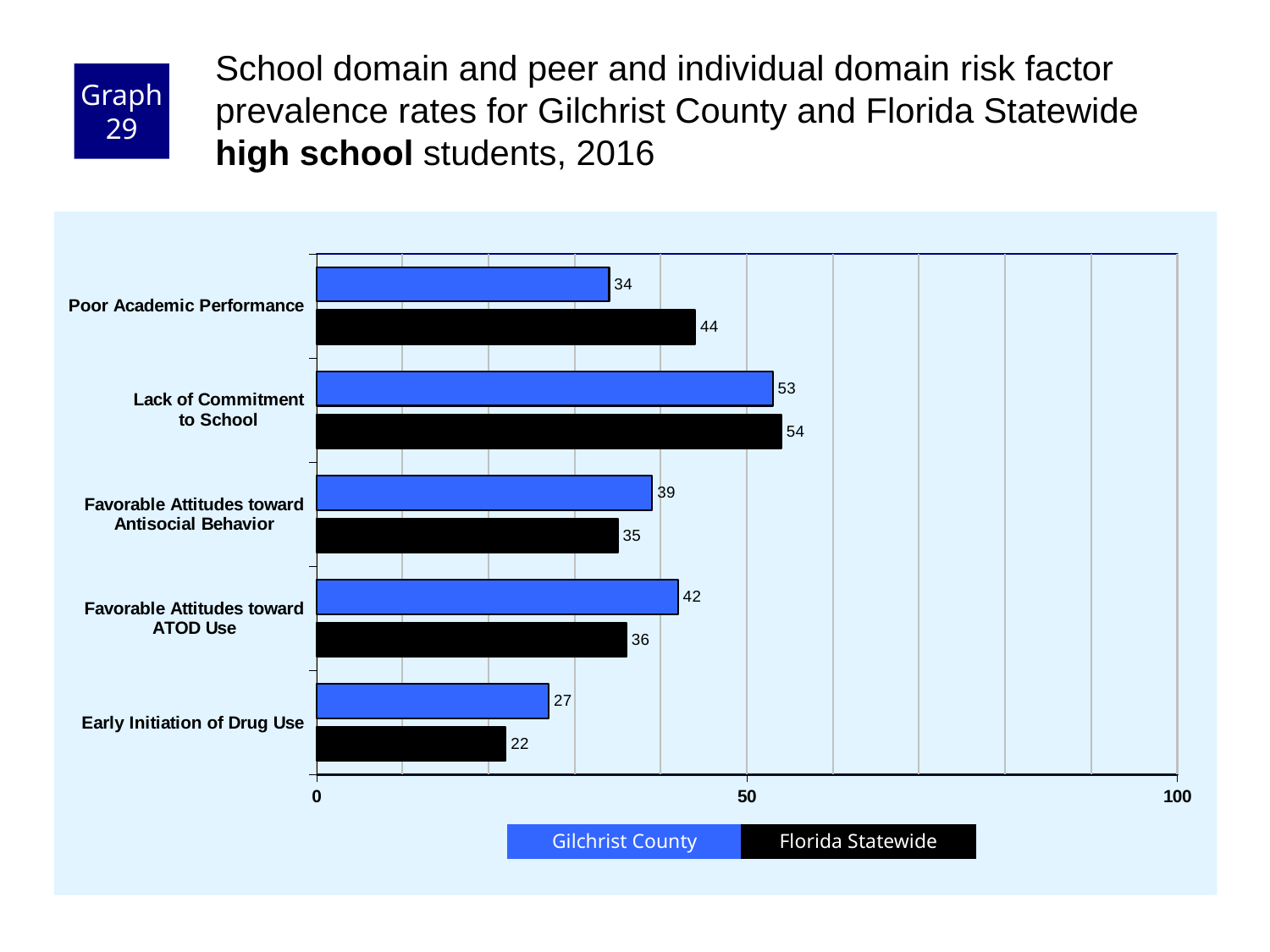
How many risk factor categories are shown on the chart? 5 What kind of chart is shown on the slide? bar chart What is the Gilchrist County value for Early Initiation of Drug Use? 27 What is the Florida Statewide value for Lack of Commitment to School? 54 How many series does the legend list? 2 What is the difference between the Florida Statewide and Gilchrist County values for Poor Academic Performance? 10 Which colour represents Florida Statewide in the chart? black Which risk factor has the highest Florida Statewide value? Lack of Commitment to School What is the Gilchrist County value for Poor Academic Performance? 34 For Favorable Attitudes toward ATOD Use, which is larger: Gilchrist County or Florida Statewide? Gilchrist County Which risk factor has the lowest Gilchrist County value? Early Initiation of Drug Use Is the Florida Statewide value for Lack of Commitment to School greater or less than 50? greater